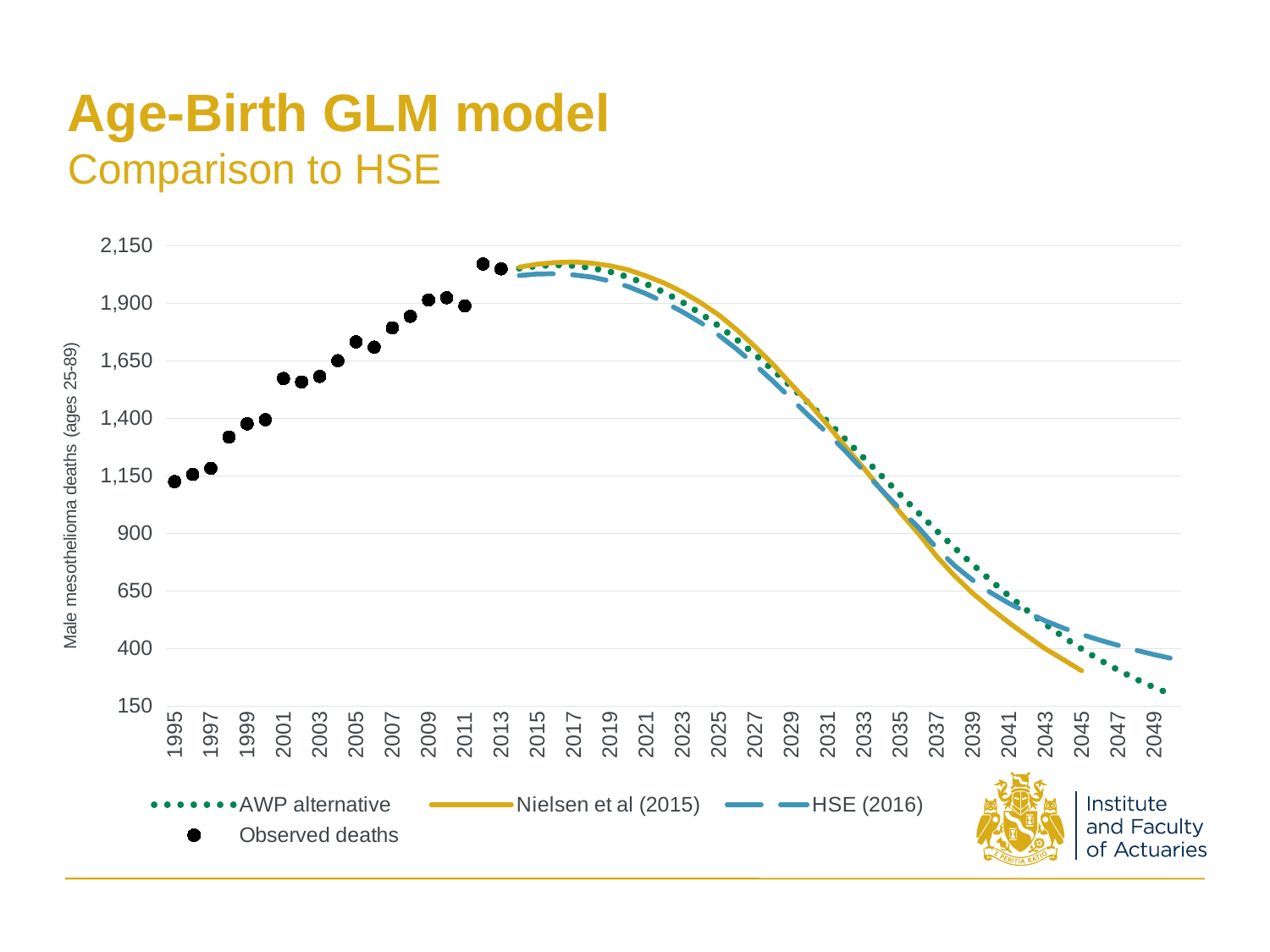
What kind of chart is shown on the slide? Line chart Is the AWP alternative value for 2049 greater or less than 400? less Do the observed deaths rise or fall between 1995 and 2013? Rise Do the projected values for Nielsen et al (2015) rise or fall between 2025 and 2045? Fall Is the Nielsen et al (2015) value for 2045 greater or less than 400? less In 2043, which is lower: Nielsen et al (2015) or HSE (2016)? Nielsen et al (2015) In 2049, which is higher: the AWP alternative or HSE (2016)? HSE (2016) Is the Nielsen et al (2015) value for 2025 greater or less than 1,650? greater Which series is shown as black dots? Observed deaths What is the label on the vertical axis? Male mesothelioma deaths (ages 25-89) How many series does the legend list? 4